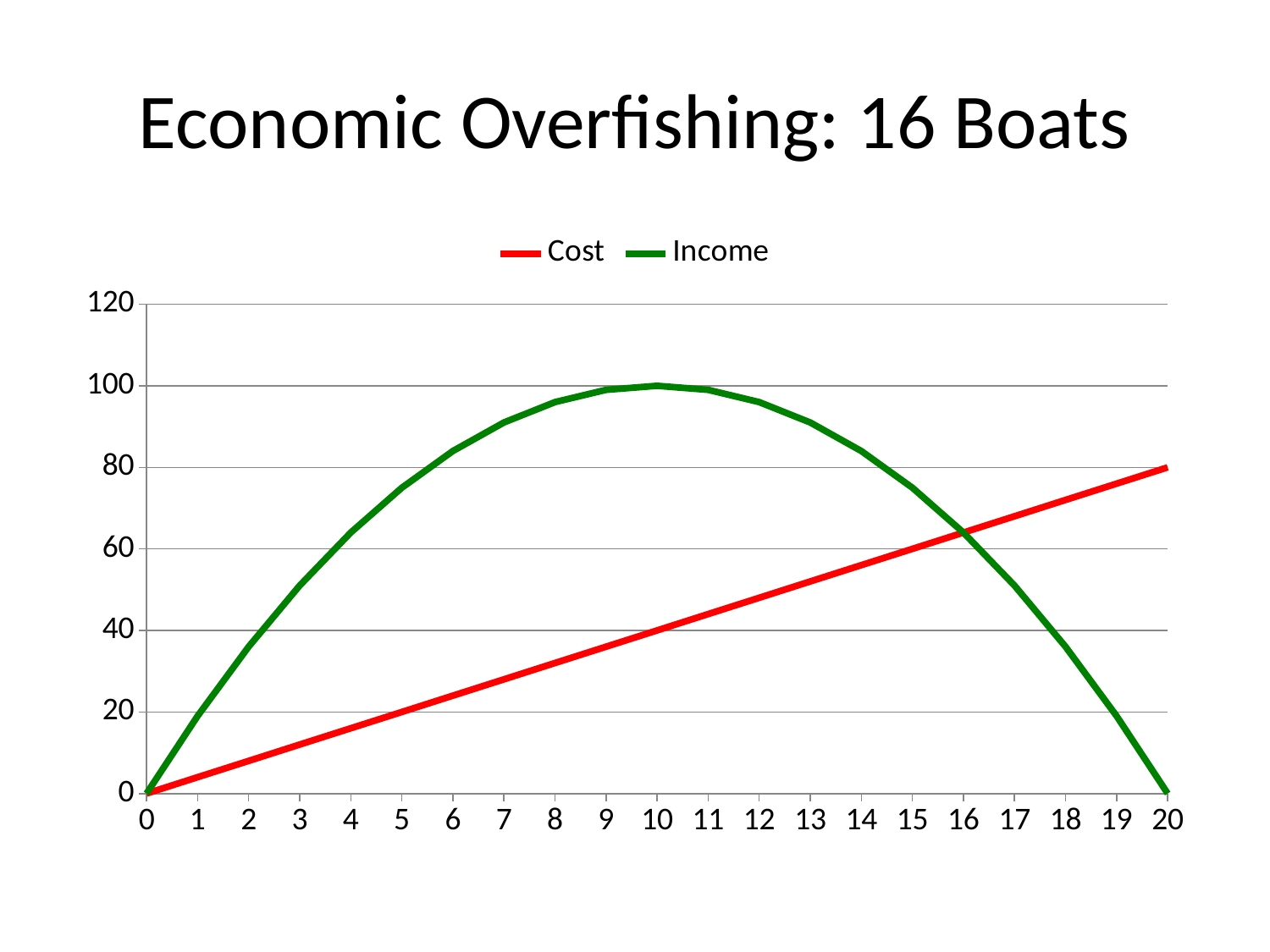
What kind of chart is shown on the slide? line chart What is the Cost value at x = 10? 40 Is the Income value at x = 5 greater or less than 60? greater What is the Cost value at x = 20? 80 Is the Cost value at x = 3 greater or less than 20? less At x = 18, which series has the larger value, Cost or Income? Cost How many series does the legend list? 2 What are the names of the two series in the legend? Cost and Income What is the Income value at x = 20? 0 What is the Income value at x = 10? 100 What is the title of the slide? Economic Overfishing: 16 Boats At which x value does the Income series reach its highest point? 10